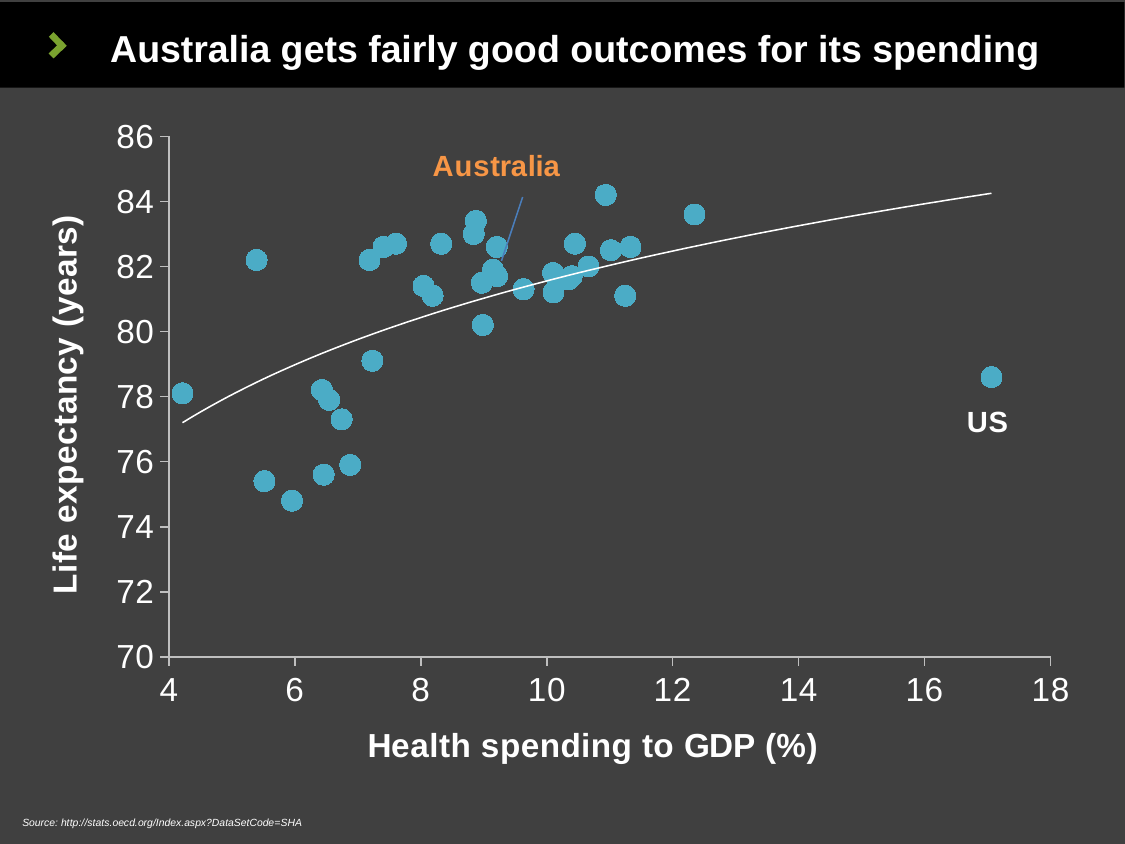
What kind of chart is shown on the slide? scatter plot Is the health spending to GDP value for Australia greater or less than 12? less Which labelled country is the furthest to the right on the chart? US Does the fitted trend line rise or fall as health spending to GDP increases? rises Is the health spending to GDP value for the US greater or less than 16? greater Which of the two labelled countries, Australia or the US, spends a larger share of GDP on health? US What does the vertical axis of the chart measure? Life expectancy (years) Is the life expectancy value for Australia greater or less than 80? greater Which of the two labelled countries, Australia or the US, has the higher life expectancy? Australia What is the title of the chart on the slide? Australia gets fairly good outcomes for its spending